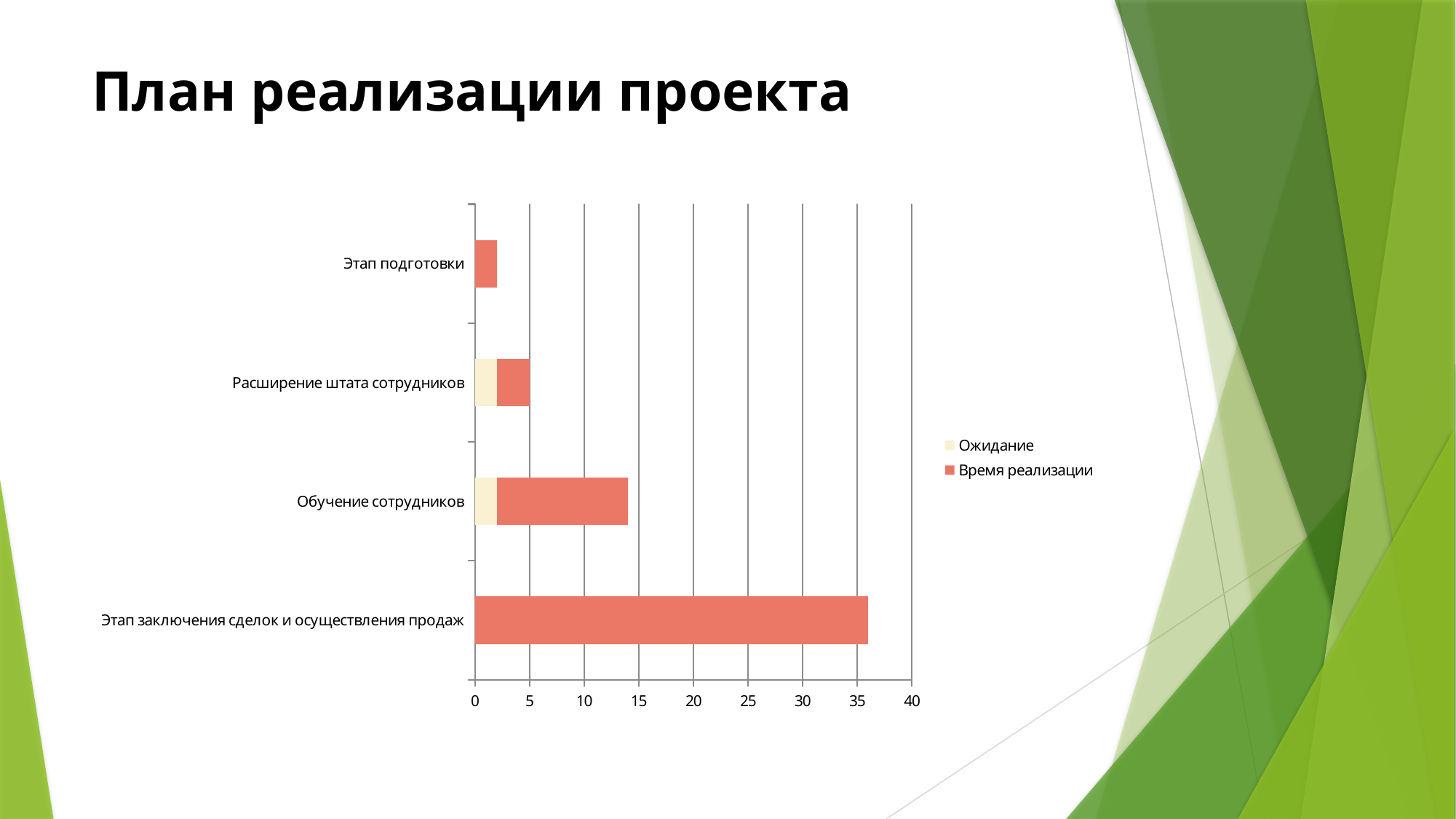
Is the value for Этап подготовки greater or less than 5? less Is the total value for Этап заключения сделок и осуществления продаж greater or less than 30? greater What is the title of the slide containing the chart? План реализации проекта Which stage has the shortest bar on the chart? Этап подготовки How many categories (stages) are shown on the chart? 4 Which stage has the longest bar on the chart? Этап заключения сделок и осуществления продаж What kind of chart is shown on the slide? bar chart Is the total value for Обучение сотрудников greater or less than 10? greater What are the two series names listed in the chart legend? Ожидание, Время реализации Which bar is longer: Обучение сотрудников or Расширение штата сотрудников? Обучение сотрудников How many series does the chart legend list? 2